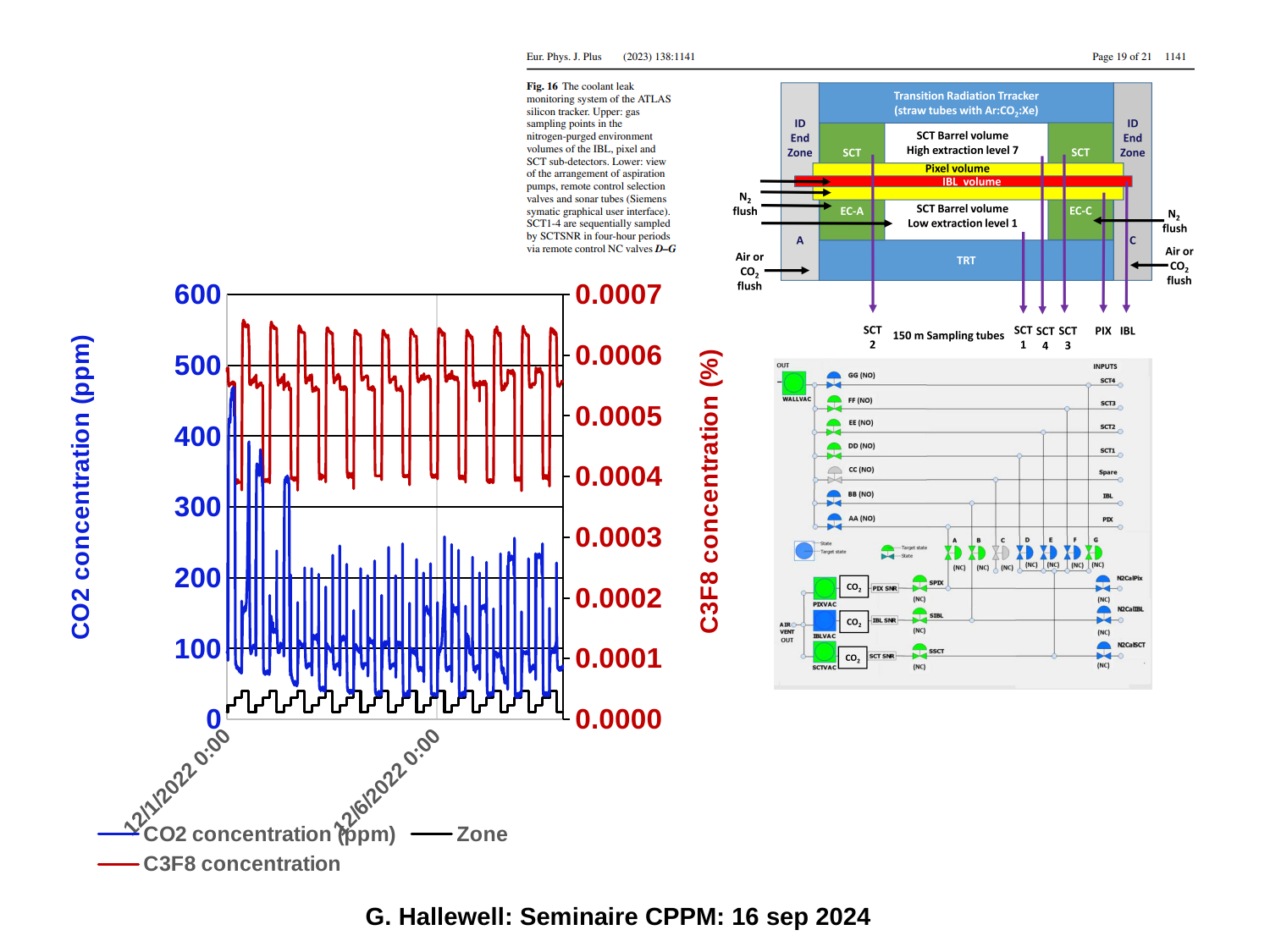
What is the title of the right-hand vertical axis of the chart? C3F8 concentration (%) Is the highest value of the CO2 concentration (ppm) series greater or less than 500? less What are the three series named in the chart's legend? CO2 concentration (ppm), Zone, C3F8 concentration Is the maximum value of the Zone series, read on the left axis, greater or less than 100? less How many series does the chart's legend list? 3 Is the highest value of the C3F8 concentration series greater or less than 0.0005? greater What type of chart is shown on the slide? Line chart Are the peaks of the CO2 concentration (ppm) series higher at the start of the period or later in the period? At the start